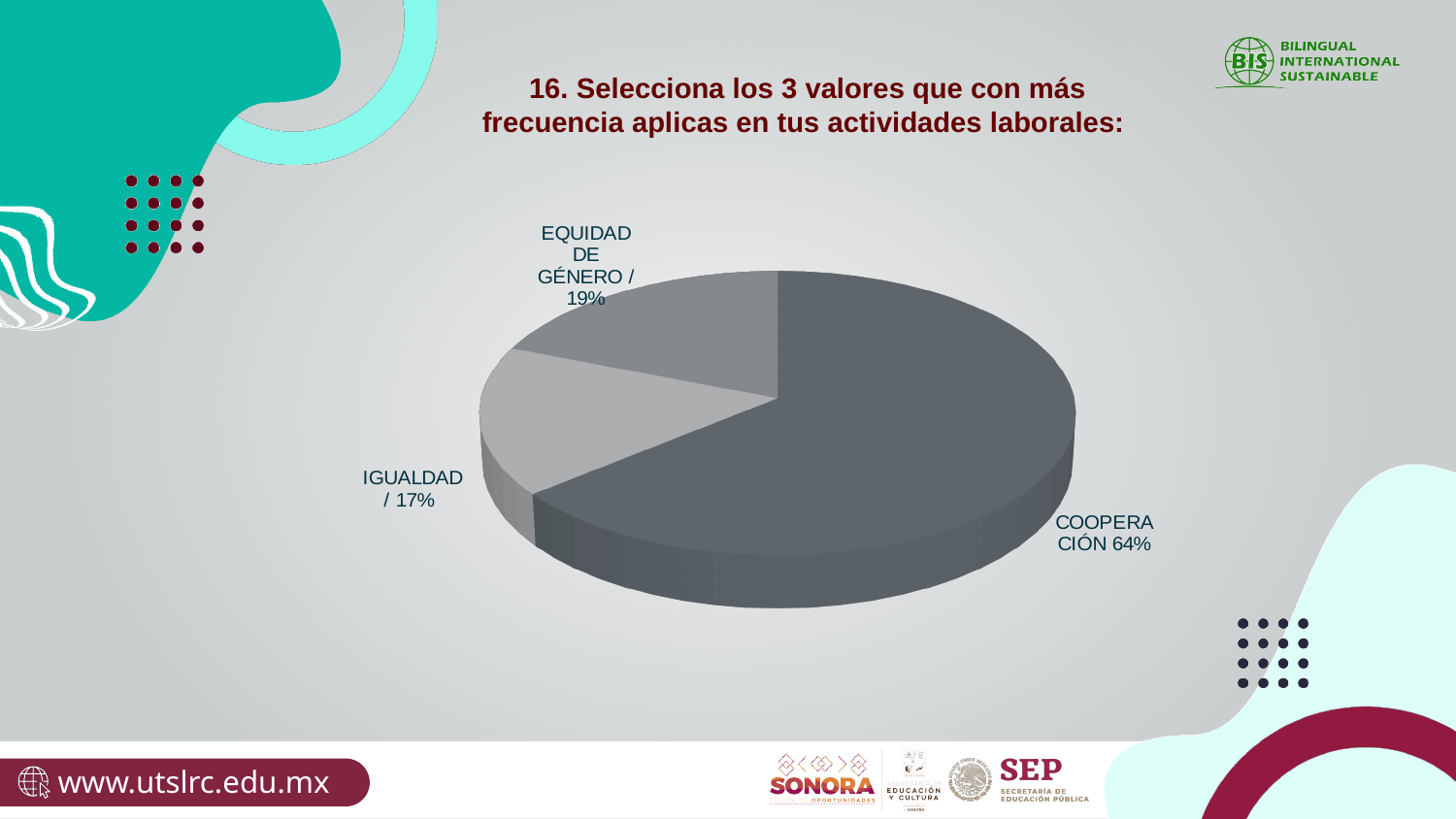
What percentage is shown for EQUIDAD DE GÉNERO? 19% What is the difference in percentage points between COOPERACIÓN and EQUIDAD DE GÉNERO? 45 Which is larger, the share for EQUIDAD DE GÉNERO or the share for IGUALDAD? EQUIDAD DE GÉNERO Which category has the smallest share of the pie? IGUALDAD What kind of chart is shown on the slide? pie chart What percentage is shown for COOPERACIÓN? 64% What percentage is shown for IGUALDAD? 17% Is the share for COOPERACIÓN greater or less than 50%? greater How many slices does the pie chart have? 3 What is the difference in percentage points between EQUIDAD DE GÉNERO and IGUALDAD? 2 What is the title of the chart? 16. Selecciona los 3 valores que con más frecuencia aplicas en tus actividades laborales: Which category has the largest share of the pie? COOPERACIÓN